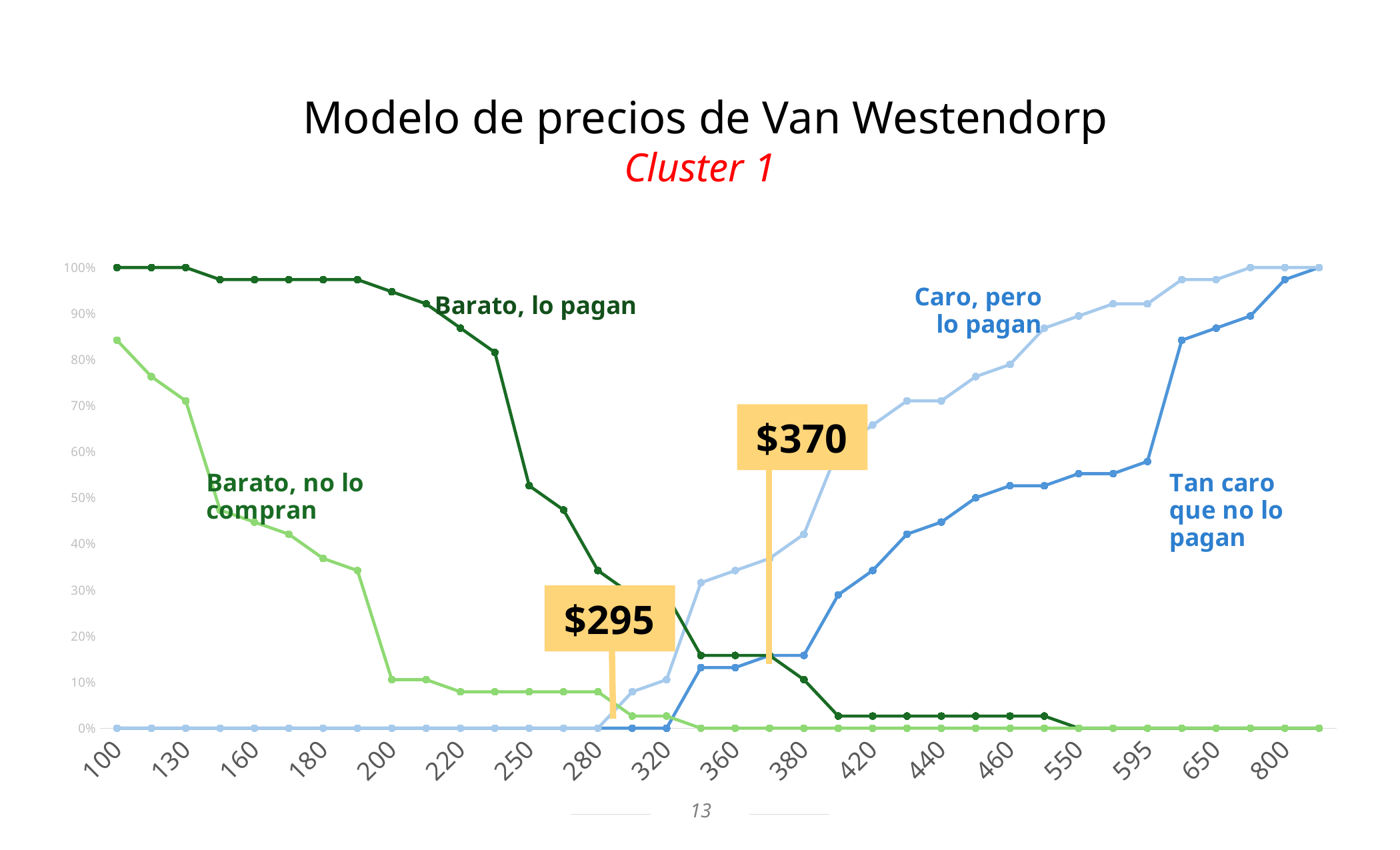
Does the 'Caro, pero lo pagan' line rise or fall as the price increases along the x axis? rises What is the main title of the chart on the slide? Modelo de precios de Van Westendorp Is the value of the 'Barato, no lo compran' line at the price 100 greater or less than 80%? greater What is the value of the 'Barato, lo pagan' line at the price 100? 100% Does the 'Barato, lo pagan' line rise or fall as the price increases along the x axis? falls What are the two price values highlighted in the yellow callout boxes on the chart? $295 and $370 Is the value of the 'Barato, lo pagan' line at the price 250 greater or less than 60%? less What kind of chart is shown on the slide? line chart What is the value of the 'Tan caro que no lo pagan' line at the price 100? 0% At the price 100, which line is higher: 'Barato, lo pagan' or 'Barato, no lo compran'? Barato, lo pagan Which cluster does the subtitle say the chart refers to? Cluster 1 What is the value of the 'Caro, pero lo pagan' line at the price 800? 100%